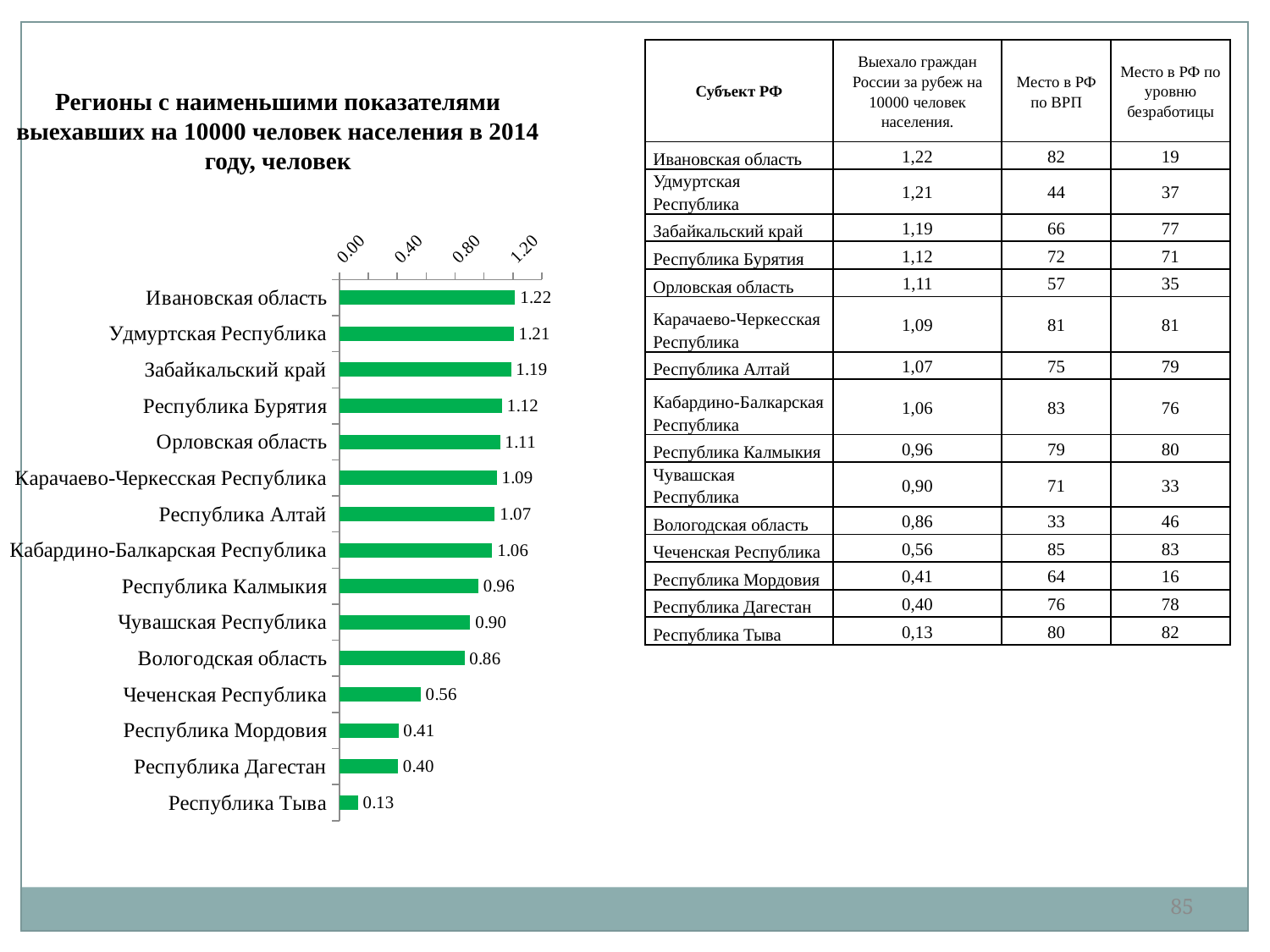
What is the value for Чеченская Республика in the bar chart? 0.56 What is the difference between the values for Вологодская область and Чеченская Республика? 0.30 What type of chart is shown on the slide? bar chart What colour are the bars in the chart? green Which region has the lowest value in the bar chart? Республика Тыва Is the value for Республика Мордовия greater or less than 0.80? less Which has a larger value, Республика Бурятия or Чувашская Республика? Республика Бурятия What is the difference between the values for Ивановская область and Республика Тыва? 1.09 What is the value for Ивановская область in the bar chart? 1.22 Which region has the highest value in the bar chart? Ивановская область How many regions are plotted in the bar chart? 15 What is the value for Республика Калмыкия in the bar chart? 0.96